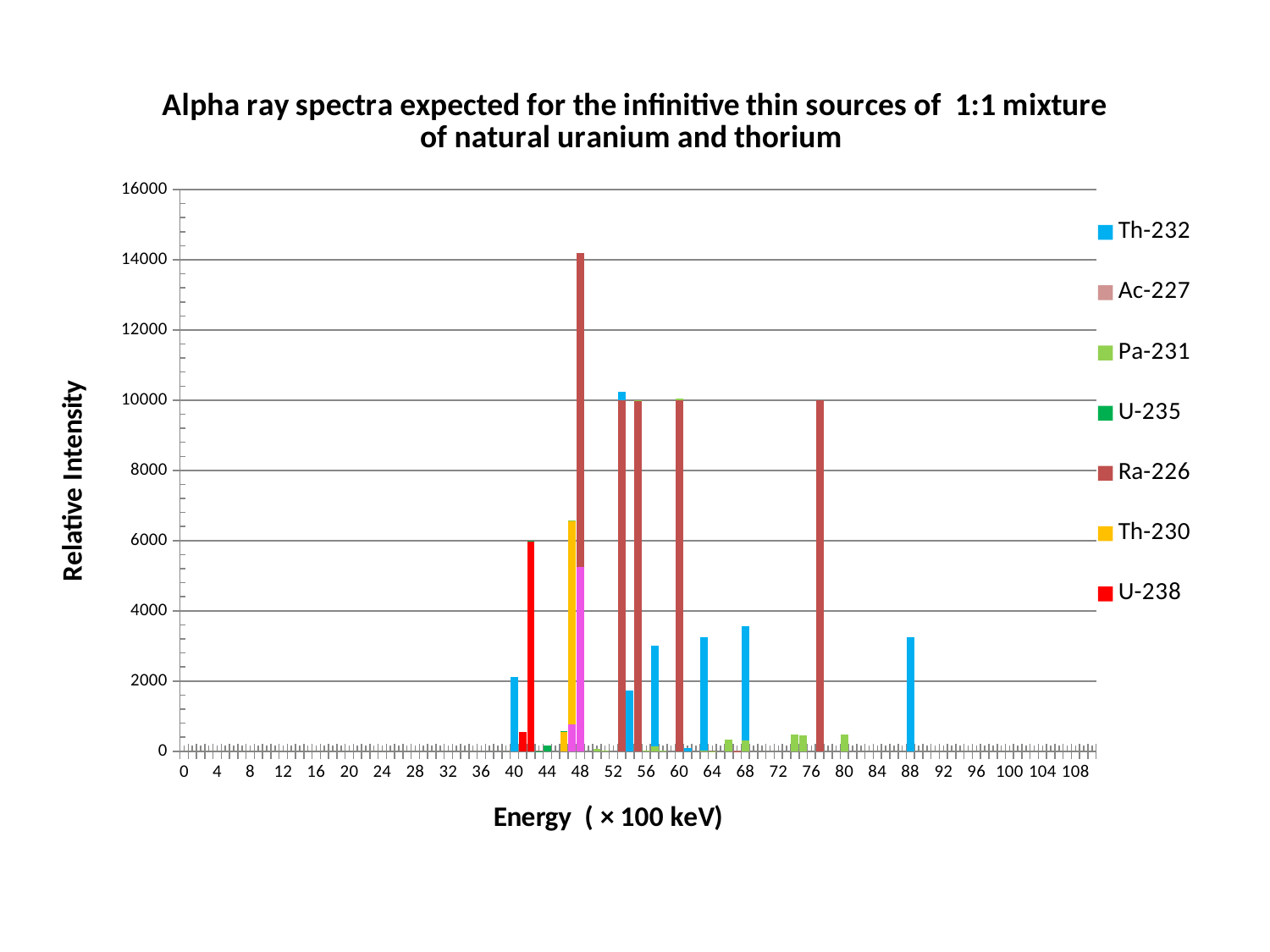
Which is taller: the Th-232 bar near energy 68 or the Th-232 bar near energy 40? the bar near energy 68 What kind of chart is shown on the slide? bar chart Is the Th-232 bar near energy 88 greater or less than 2000? greater Is the Th-232 bar near energy 88 greater or less than 4000? less Is the U-238 bar near energy 42 greater or less than 4000? greater Which colour represents U-238 in the legend? red Which series has the tallest bar in the chart? Ra-226 Which is taller: the U-238 bar near energy 42 or the Th-232 bar near energy 57? the U-238 bar near energy 42 What is the label of the vertical axis? Relative Intensity How many series does the legend list? 7